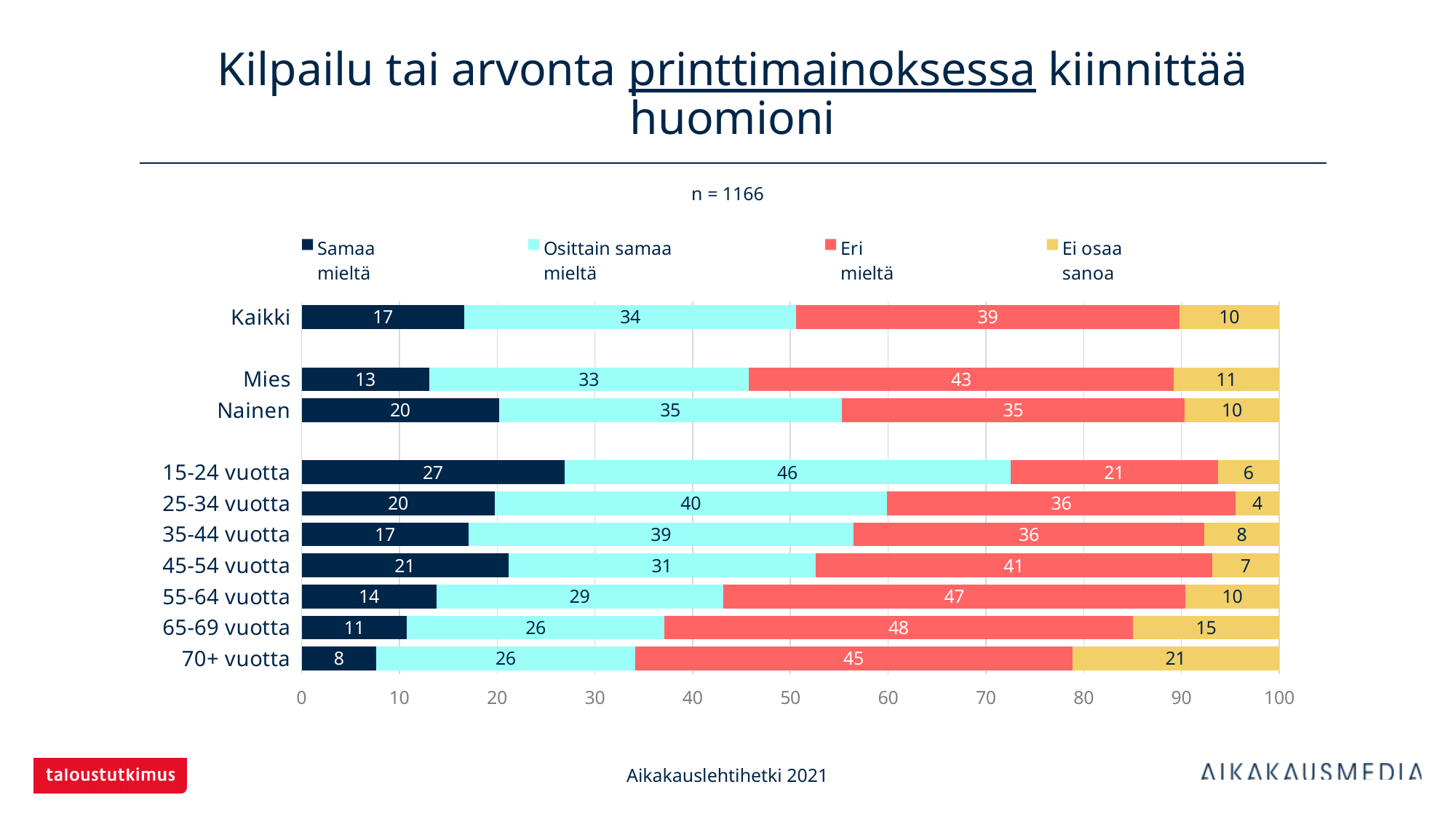
What is the value of "Eri mieltä" for Mies? 43 Which is larger: the "Osittain samaa mieltä" value for 15-24 vuotta or for 55-64 vuotta? 15-24 vuotta Which category has the lowest value for "Ei osaa sanoa"? 25-34 vuotta What is the total of the stacked bar for 65-69 vuotta? 100 What is the value of "Samaa mieltä" for Kaikki? 17 What sample size (n) is stated above the chart? n = 1166 What is the value of "Ei osaa sanoa" for 70+ vuotta? 21 How many series does the legend list? 4 What kind of chart is shown on the slide? Stacked bar chart How many categories are shown on the y axis of the chart? 10 Which category has the highest value for "Samaa mieltä"? 15-24 vuotta What is the difference between the "Eri mieltä" values for Mies and Nainen? 8